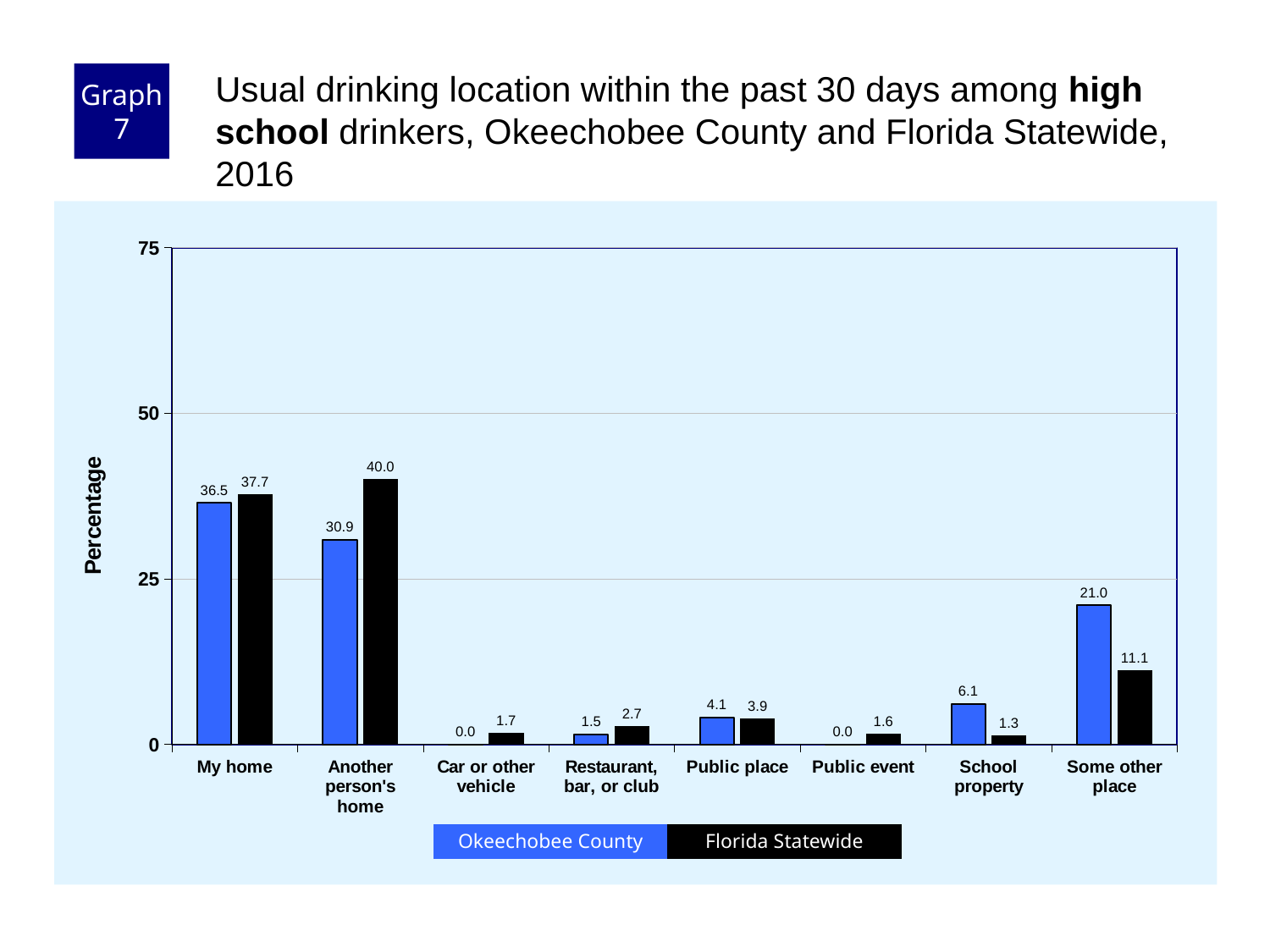
Is the Florida Statewide value for My home greater or less than 50? less How many categories are shown on the x axis? 8 What is the Okeechobee County value for Some other place? 21.0 What is the difference between the Florida Statewide and Okeechobee County values for Another person's home? 9.1 What is the Okeechobee County value for My home? 36.5 Which category has the highest Okeechobee County value? My home Which category has the highest Florida Statewide value? Another person's home What is the Florida Statewide value for Another person's home? 40.0 What is the difference between the Okeechobee County and Florida Statewide values for Some other place? 9.9 How many series does the legend list? 2 What kind of chart is shown? bar chart Which is larger for School property: Okeechobee County or Florida Statewide? Okeechobee County